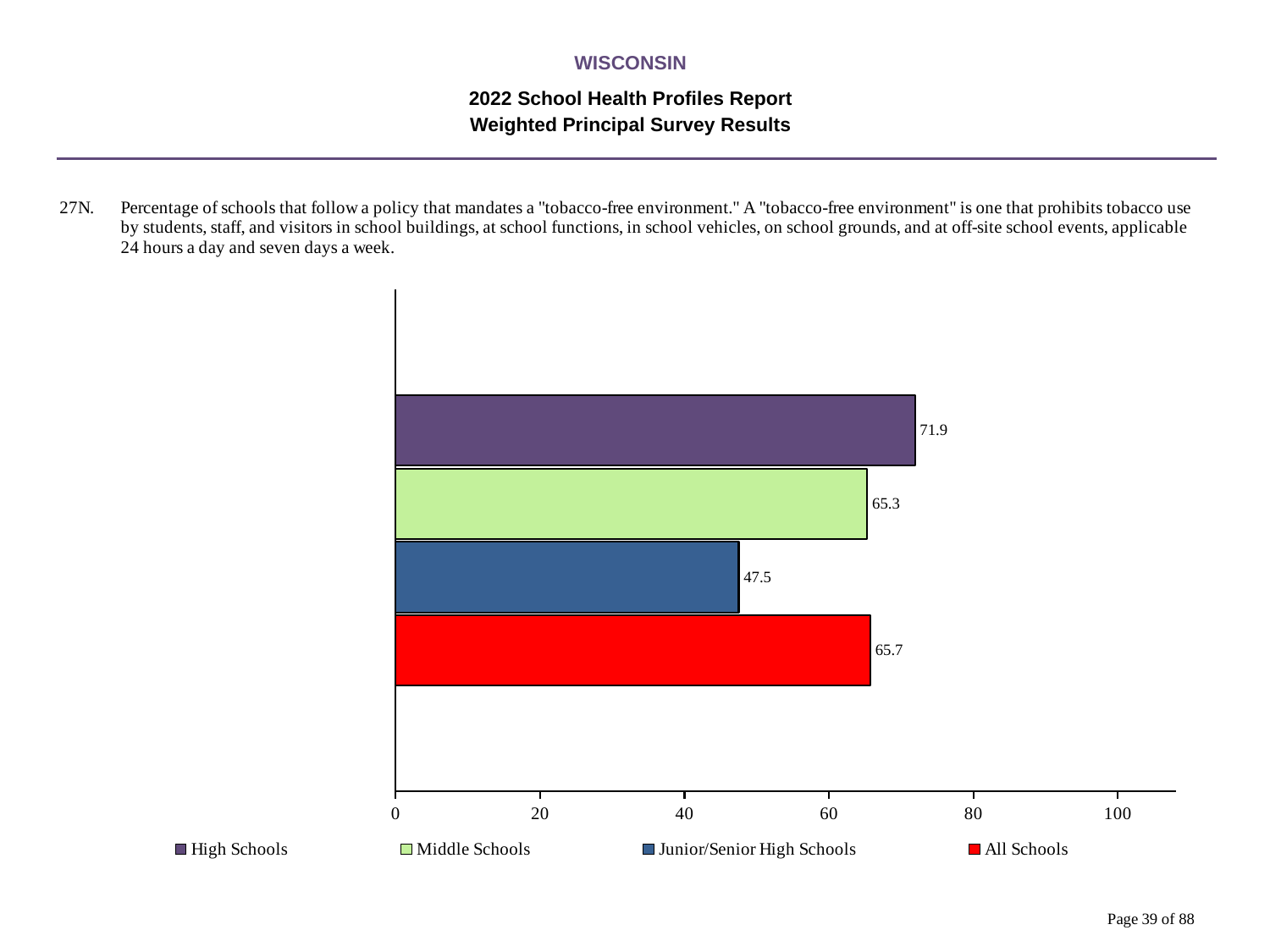
What is the value for High Schools? 71.9 Which is larger, the value for High Schools or the value for Middle Schools? High Schools What is the difference between the values for High Schools and Junior/Senior High Schools? 24.4 Which school type has the lowest value? Junior/Senior High Schools What kind of chart is shown on the slide? bar chart What is the value for All Schools? 65.7 Which school type has the highest value? High Schools What is the value for Junior/Senior High Schools? 47.5 What is the value for Middle Schools? 65.3 Is the value for Junior/Senior High Schools greater or less than 60? less How many entries does the legend list? 4 How many bars are shown in the chart? 4